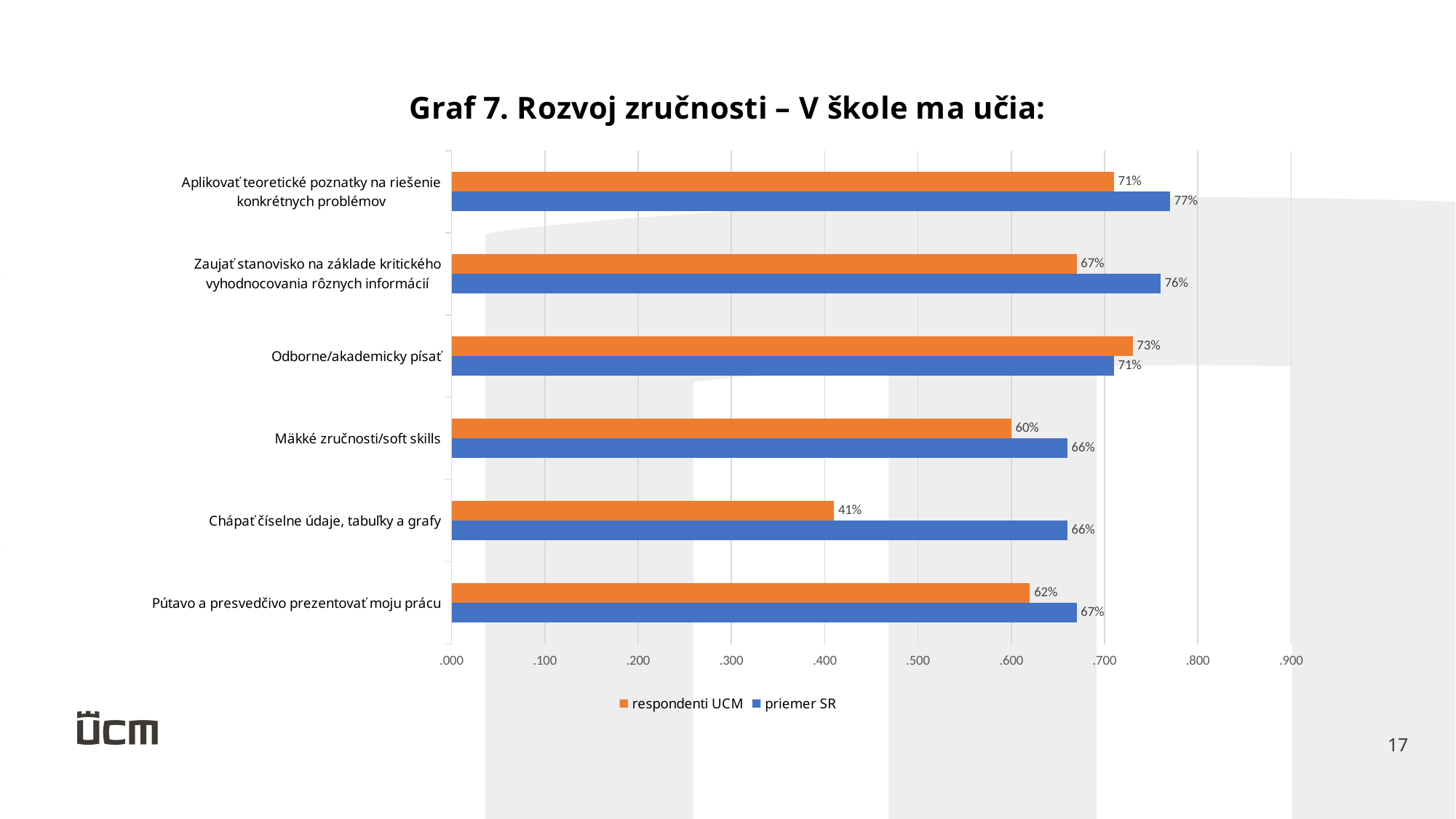
What is the value for 'priemer SR' in the category 'Zaujať stanovisko na základe kritického vyhodnocovania rôznych informácií'? 76% Which category has the highest value for 'priemer SR'? Aplikovať teoretické poznatky na riešenie konkrétnych problémov Which category has the lowest value for 'respondenti UCM'? Chápať číselne údaje, tabuľky a grafy What is the value for 'respondenti UCM' in the category 'Chápať číselne údaje, tabuľky a grafy'? 41% How many categories are shown on the chart? 6 Is the value for 'respondenti UCM' in 'Mäkké zručnosti/soft skills' greater or less than .500? greater What kind of chart is shown on the slide? bar chart How many series does the legend list? 2 What is the value for 'respondenti UCM' in the category 'Aplikovať teoretické poznatky na riešenie konkrétnych problémov'? 71% What is the difference between 'priemer SR' and 'respondenti UCM' in the category 'Chápať číselne údaje, tabuľky a grafy'? 25% In the category 'Odborne/akademicky písať', which series has the larger value, 'respondenti UCM' or 'priemer SR'? respondenti UCM What is the title of the chart? Graf 7. Rozvoj zručnosti – V škole ma učia: